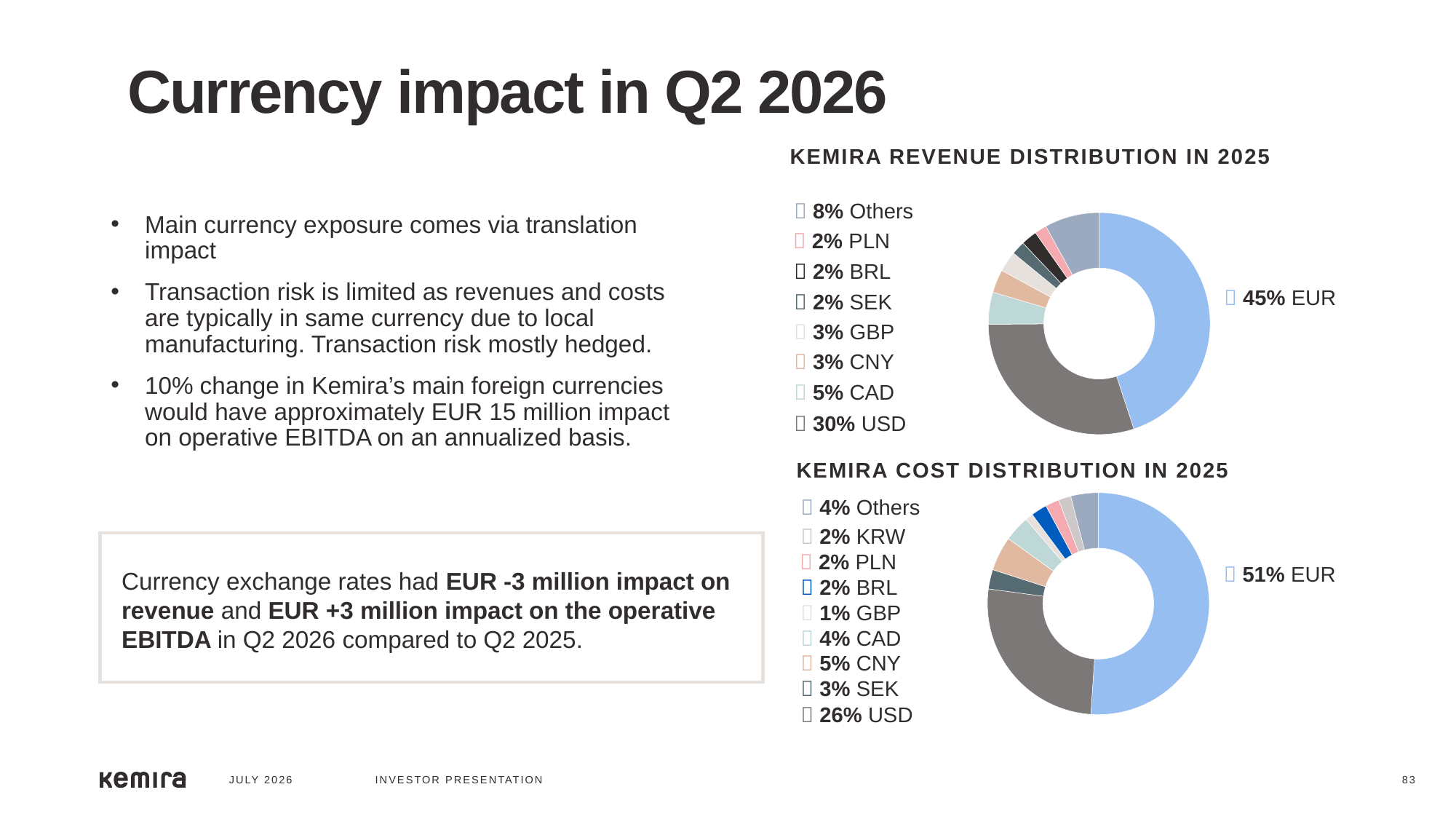
In the Kemira cost distribution in 2025 chart, what share of costs is in EUR? 51% In the Kemira revenue distribution in 2025 chart, what is the difference between the EUR share and the USD share? 15% How many currency categories are shown in the Kemira revenue distribution in 2025 chart? 9 In the Kemira cost distribution in 2025 chart, what is the difference between the EUR share and the USD share? 25% In the Kemira cost distribution in 2025 chart, which currency has the smallest share? GBP In the Kemira revenue distribution in 2025 chart, what share of revenue is in EUR? 45% How many currency categories are shown in the Kemira cost distribution in 2025 chart? 10 Which is larger: the CAD share in the revenue distribution chart or the CAD share in the cost distribution chart? Revenue distribution (5%) In the Kemira revenue distribution in 2025 chart, what share of revenue is in USD? 30% In the Kemira cost distribution in 2025 chart, what share of costs is in CNY? 5% In the Kemira revenue distribution in 2025 chart, which currency has the largest share? EUR What type of chart is used for the Kemira cost distribution in 2025? Donut (pie) chart